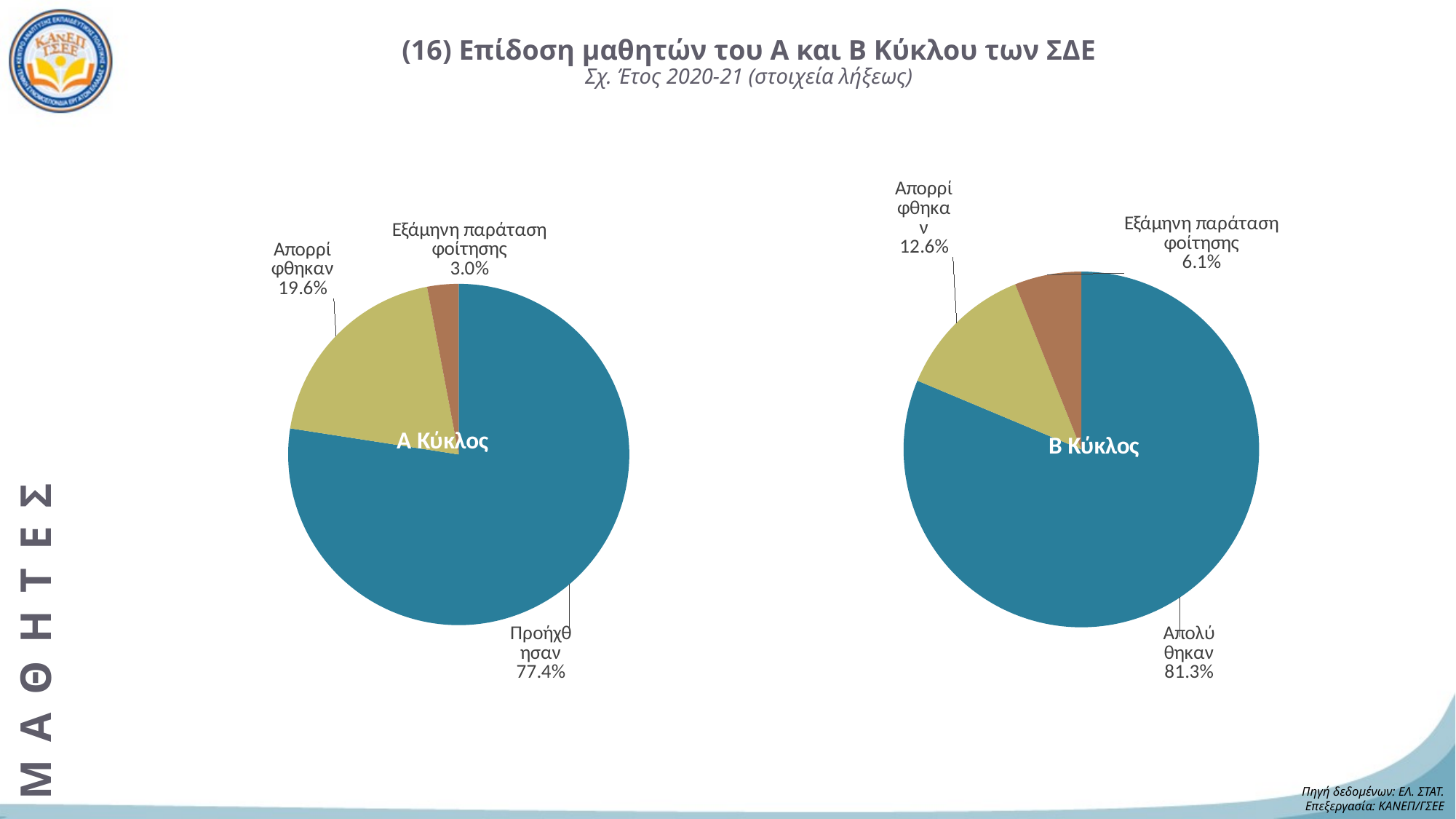
What is the difference between the Απορρίφθηκαν share in the left pie chart (Α Κύκλος) and in the right pie chart (Β Κύκλος)? 7.0% Which is larger: the Εξάμηνη παράταση φοίτησης share in the left pie chart (Α Κύκλος) or in the right pie chart (Β Κύκλος)? Β Κύκλος In the left pie chart (Α Κύκλος), what share of students is labelled Προήχθησαν? 77.4% What type of chart is used for Β Κύκλος on the right of the slide? Pie chart In the right pie chart (Β Κύκλος), what share of students is labelled Απολύθηκαν? 81.3% In the right pie chart (Β Κύκλος), what percentage is shown for Εξάμηνη παράταση φοίτησης? 6.1% In the right pie chart (Β Κύκλος), which category has the largest slice? Απολύθηκαν In the left pie chart (Α Κύκλος), which category has the smallest slice? Εξάμηνη παράταση φοίτησης How many slices does the left pie chart (Α Κύκλος) have? 3 In the left pie chart (Α Κύκλος), what percentage is shown for Εξάμηνη παράταση φοίτησης? 3.0% In the right pie chart (Β Κύκλος), what percentage is shown for Απορρίφθηκαν? 12.6% In the left pie chart (Α Κύκλος), what percentage is shown for Απορρίφθηκαν? 19.6%